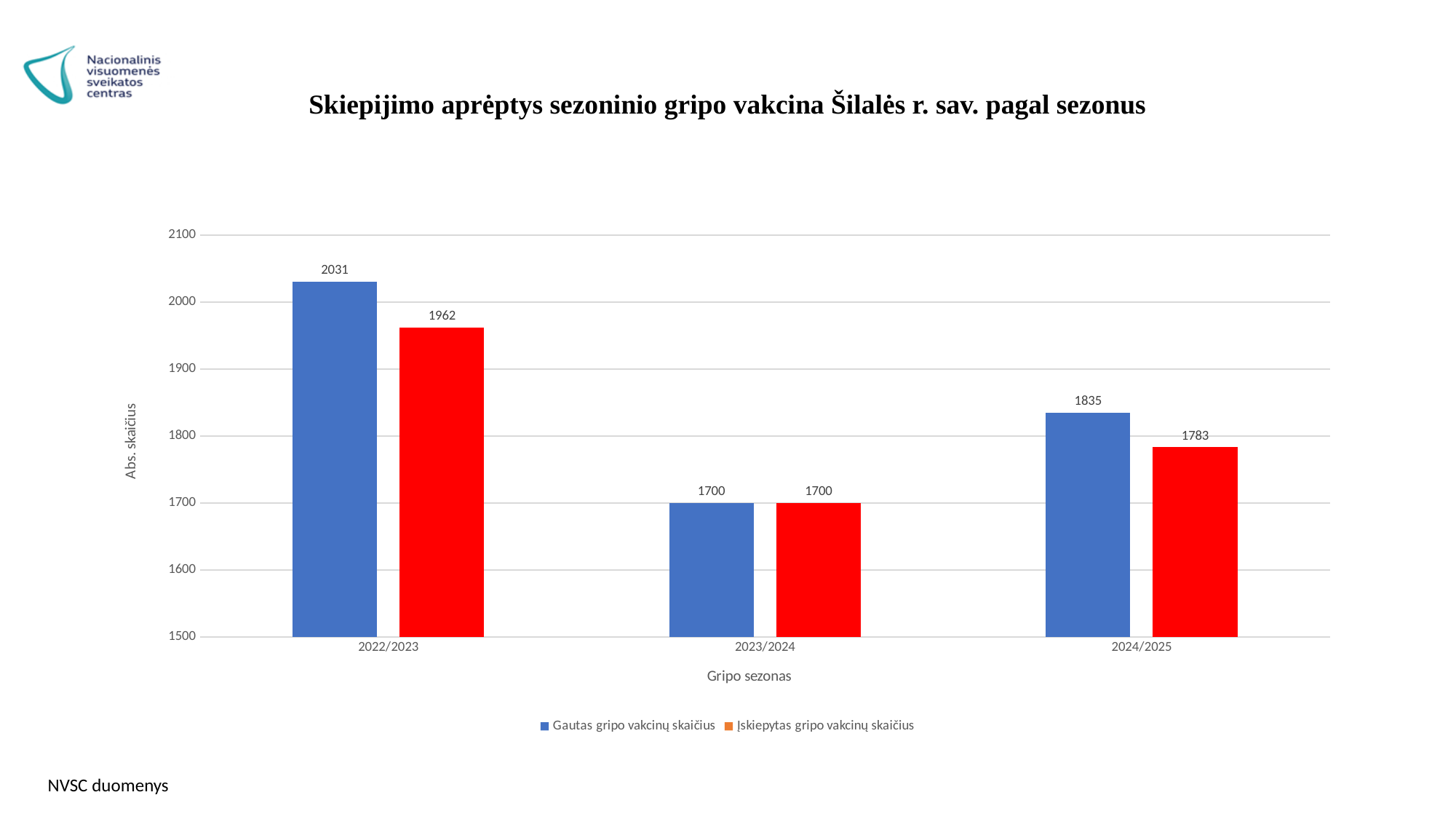
What is the value of 'Įskiepytas gripo vakcinų skaičius' for the 2024/2025 season? 1783 Which season has the highest value for 'Gautas gripo vakcinų skaičius'? 2022/2023 What is the value of 'Gautas gripo vakcinų skaičius' for the 2022/2023 season? 2031 What is the difference between 'Gautas gripo vakcinų skaičius' and 'Įskiepytas gripo vakcinų skaičius' in the 2024/2025 season? 52 What is the difference between 'Gautas gripo vakcinų skaičius' and 'Įskiepytas gripo vakcinų skaičius' in the 2022/2023 season? 69 What is the value of 'Įskiepytas gripo vakcinų skaičius' for the 2023/2024 season? 1700 Which season has the lowest value for 'Įskiepytas gripo vakcinų skaičius'? 2023/2024 How many seasons are shown on the x axis? 3 Which is larger: 'Gautas gripo vakcinų skaičius' in 2024/2025 or 'Įskiepytas gripo vakcinų skaičius' in 2022/2023? Įskiepytas gripo vakcinų skaičius in 2022/2023 What kind of chart is shown on the slide? Bar chart How many series does the legend list? 2 What is the label of the y axis? Abs. skaičius